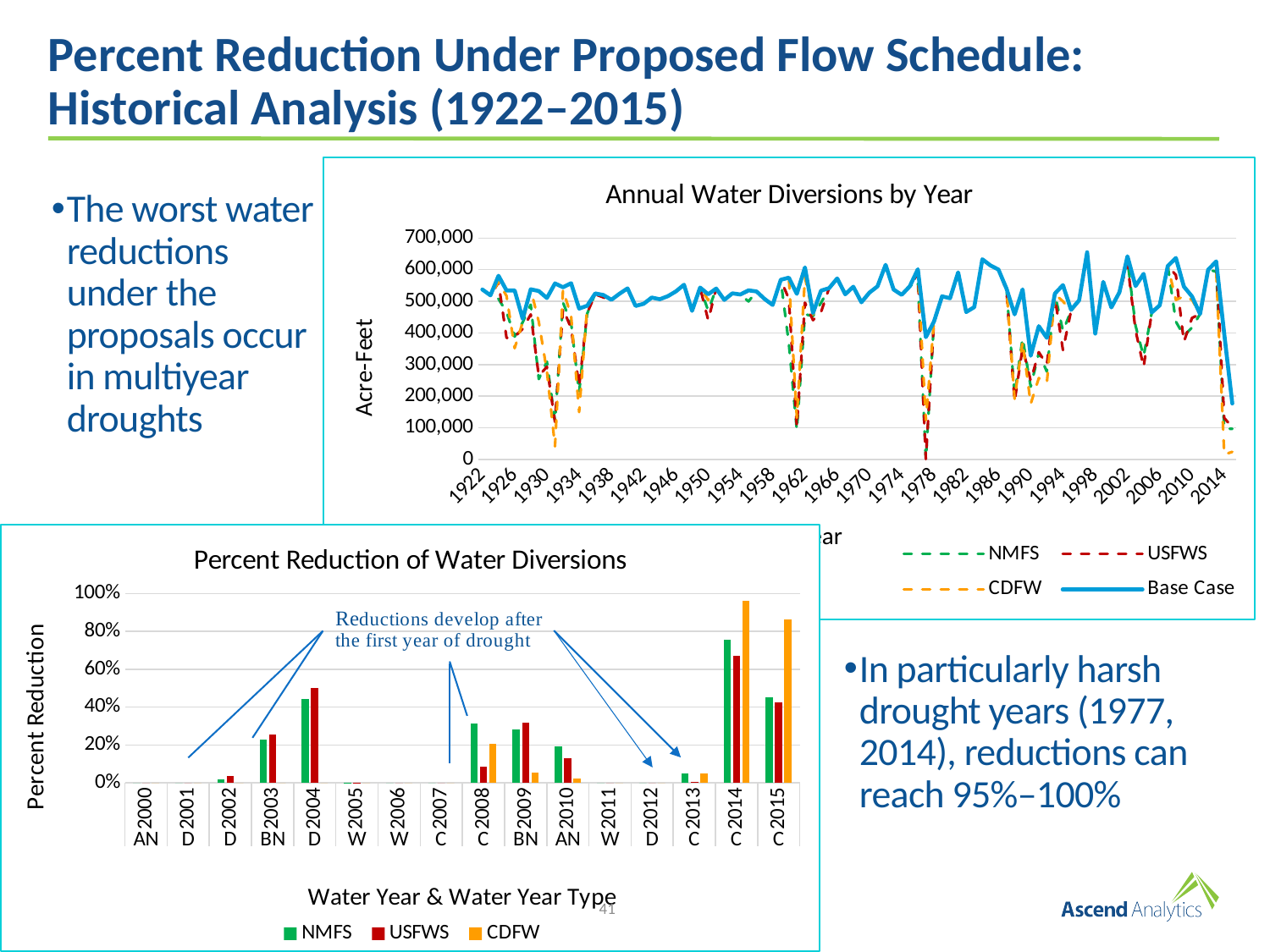
How many series does the legend of the 'Percent Reduction of Water Diversions' chart list? 3 In the 'Percent Reduction of Water Diversions' chart, is the CDFW bar larger in 2014 or in 2015? 2014 How many water years are shown on the x axis of the 'Percent Reduction of Water Diversions' chart? 16 In the 'Percent Reduction of Water Diversions' chart, which water year has the highest CDFW bar? 2014 In the 'Percent Reduction of Water Diversions' chart, is the CDFW value for 2014 greater or less than 80%? greater In the 'Percent Reduction of Water Diversions' chart, which is larger for 2004: the NMFS bar or the USFWS bar? USFWS In the 'Annual Water Diversions by Year' chart, is the NMFS value for 1977 greater or less than 100,000 acre-feet? less What kind of chart is the 'Annual Water Diversions by Year' chart? line chart How many series does the legend of the 'Annual Water Diversions by Year' chart list? 4 What is the y-axis title of the 'Percent Reduction of Water Diversions' chart? Percent Reduction What kind of chart is the 'Percent Reduction of Water Diversions' chart? bar chart In the 'Percent Reduction of Water Diversions' chart, is the NMFS value for 2013 greater or less than 20%? less